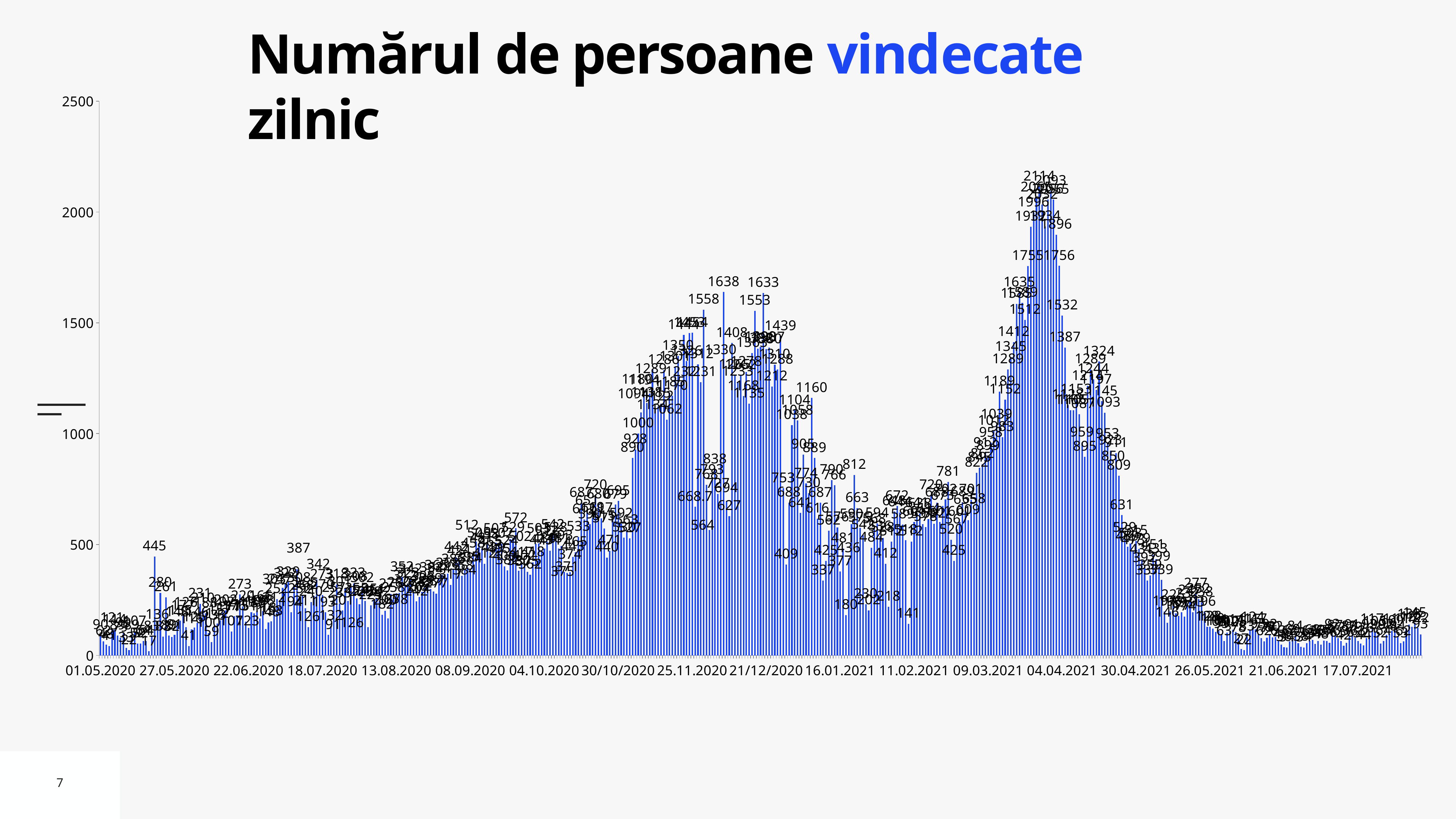
What is the value of the tallest bar in the first wave, near 27.05.2020? 445 What is the maximum value shown on the vertical axis? 2500 What is the title of the chart? Numărul de persoane vindecate zilnic What kind of chart is shown on the slide? bar chart Is the tallest bar on the chart greater or less than 2000? greater What is the value of the tallest bar near 18.07.2020? 387 Do the values rise or fall between 04.04.2021 and 26.05.2021? fall What is the difference between the overall peak (2114) and the late-November 2020 peak (1638)? 476 Do the values rise or fall between 08.09.2020 and 25.11.2020? rise Which is larger: the peak around 04.04.2021 or the peak around 25.11.2020? the peak around 04.04.2021 What is the highest daily value labelled on the chart? 2114 Are the values around 17.07.2021 greater or less than 500? less